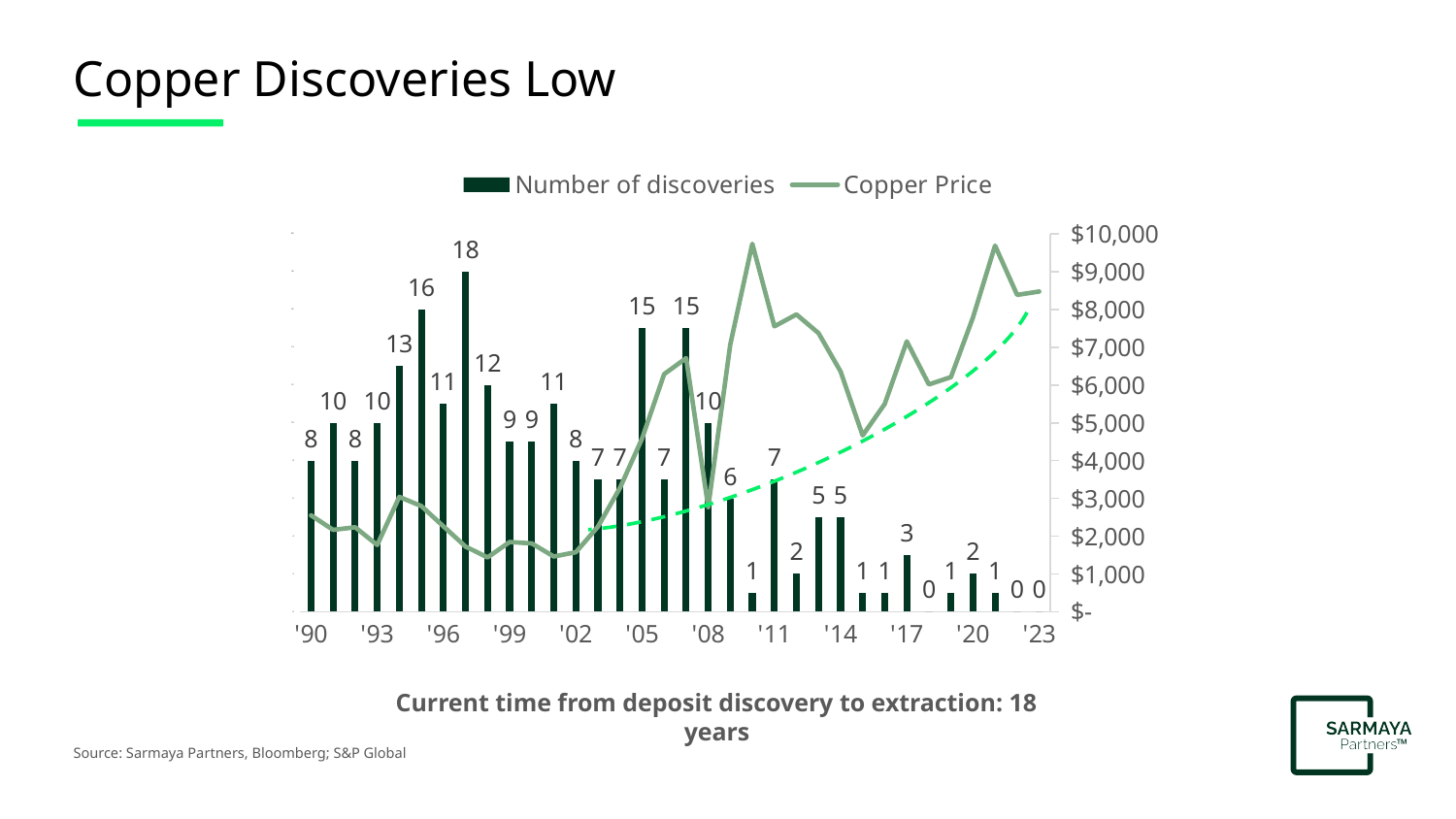
What is the highest number of discoveries shown in any year? 18 What is the number of discoveries for '05? 15 Does the number of discoveries generally rise or fall from '08 to '23? fall Is the Copper Price at '02 greater or less than $2,000? less Is the Copper Price at '23 greater or less than $8,000? greater What is the difference between the number of discoveries in '90 and in '23? 8 How many series does the legend list? 2 What is the number of discoveries for '90? 8 What is the number of discoveries for '23? 0 Which year has more discoveries, '05 or '17? '05 What kind of chart is used to show the Number of discoveries series? bar chart What are the two entries in the legend? Number of discoveries, Copper Price